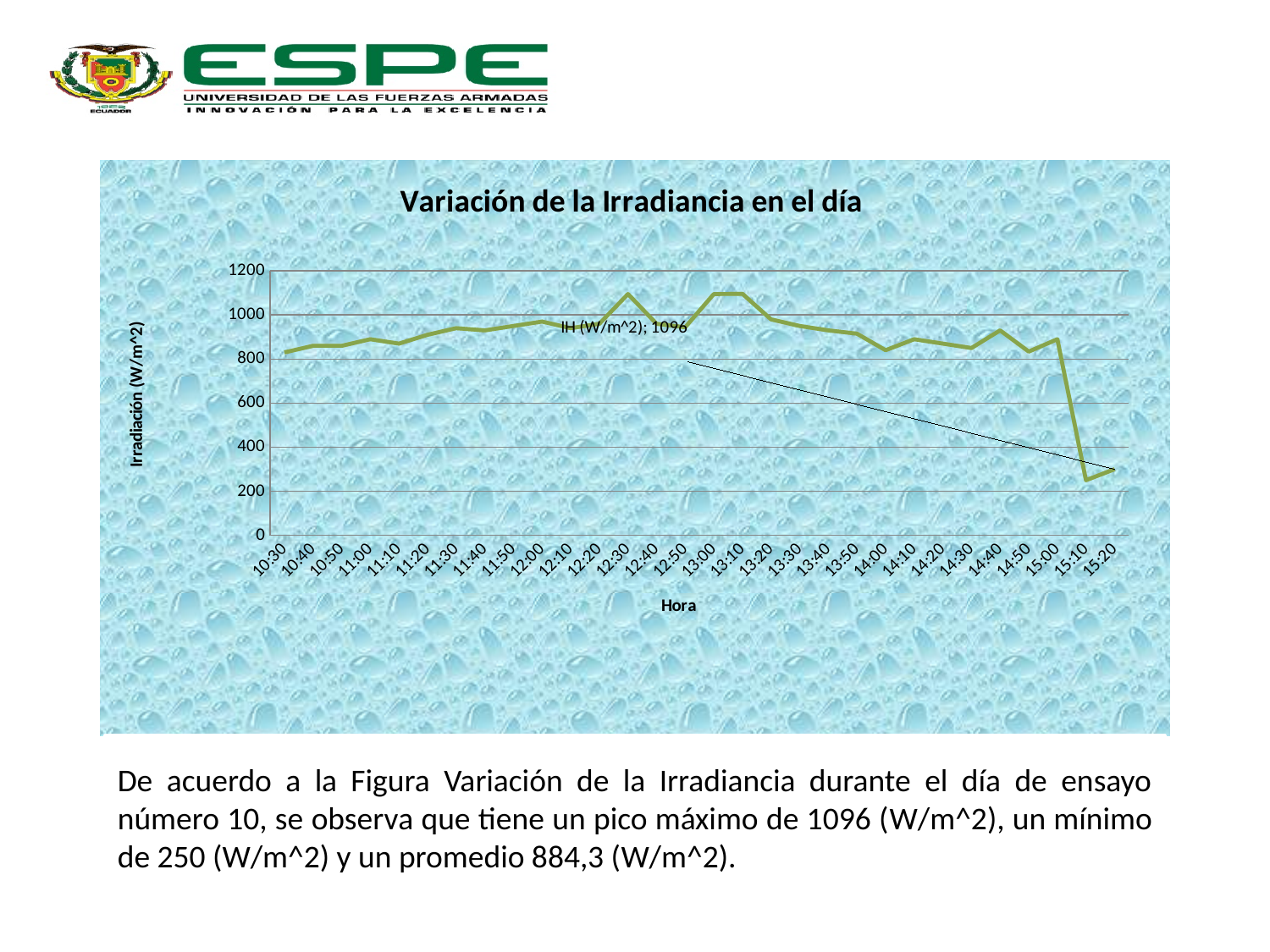
Is the irradiance value at 12:30 greater or less than 1000? greater Does the irradiance rise or fall between 15:00 and 15:10? Fall How many time points are plotted along the x axis of the chart? 30 Is the irradiance value at 15:20 greater or less than 600? less Which time has the larger irradiance value, 13:00 or 15:10? 13:00 Is the irradiance value at 15:10 greater or less than 400? less What kind of chart is shown on the slide? Line chart At which time does the irradiance reach its lowest value on the chart? 15:10 What value is printed in the data label shown on the chart? 1096 What is the label of the vertical axis of the chart? Irradiación (W/m^2) What is the title of the chart? Variación de la Irradiancia en el día